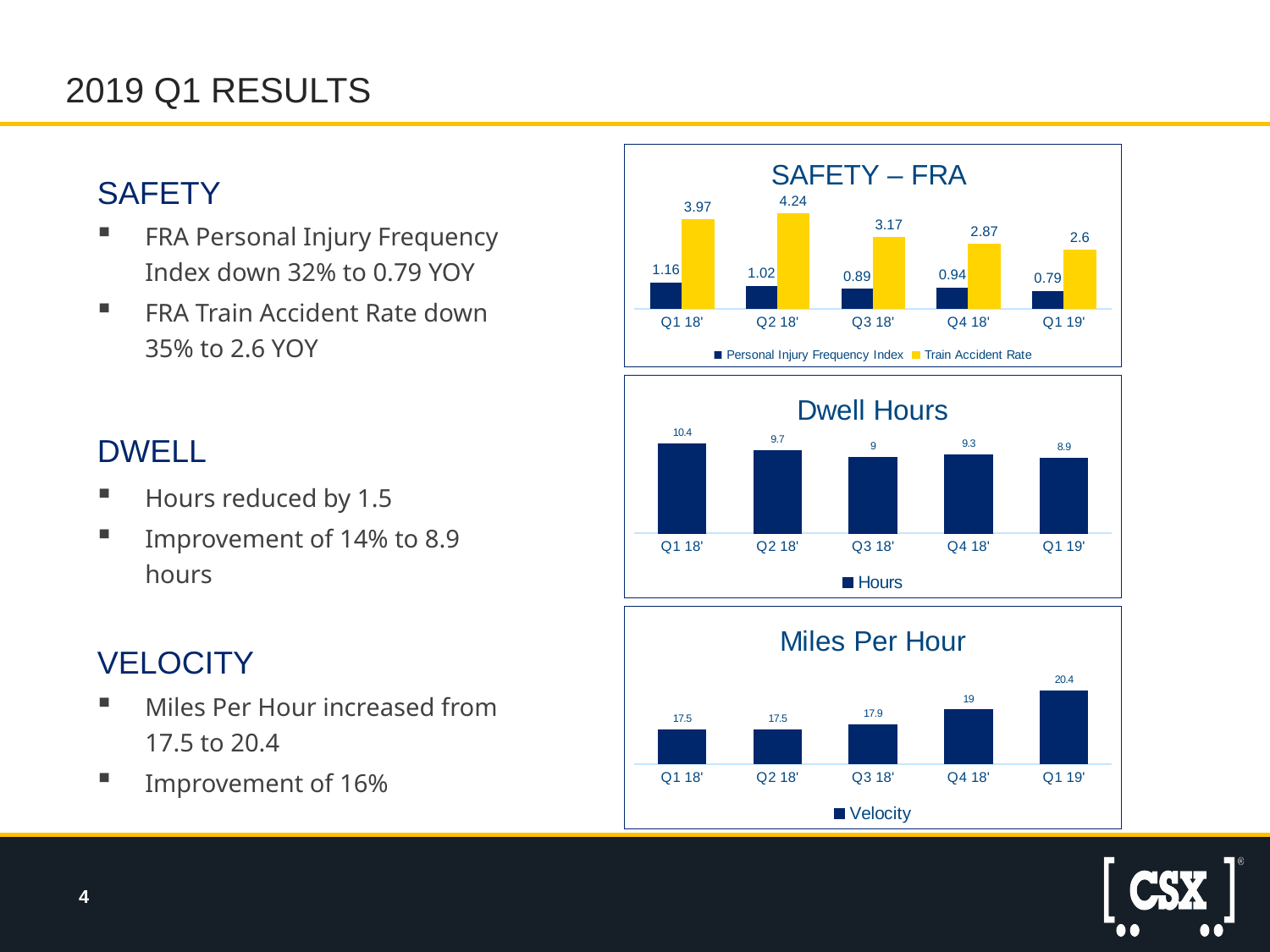
In the Miles Per Hour chart, which quarter has the highest value? Q1 19' In the Dwell Hours chart, what is the difference between Q1 18' and Q1 19'? 1.5 In the Dwell Hours chart, what is the value for Q3 18'? 9 In the Miles Per Hour chart, is the value for Q1 19' larger or smaller than the value for Q3 18'? larger In the SAFETY – FRA chart, what is the Personal Injury Frequency Index for Q1 19'? 0.79 In the Dwell Hours chart, which quarter has the lowest value? Q1 19' In the SAFETY – FRA chart, which quarter has the highest Train Accident Rate? Q2 18' In the SAFETY – FRA chart, what is the difference between the Train Accident Rate in Q1 18' and Q1 19'? 1.37 How many series does the legend of the SAFETY – FRA chart list? 2 How many quarters are shown on the x axis of the Miles Per Hour chart? 5 In the SAFETY – FRA chart, what is the Train Accident Rate for Q2 18'? 4.24 In the Miles Per Hour chart, what is the value for Q4 18'? 19